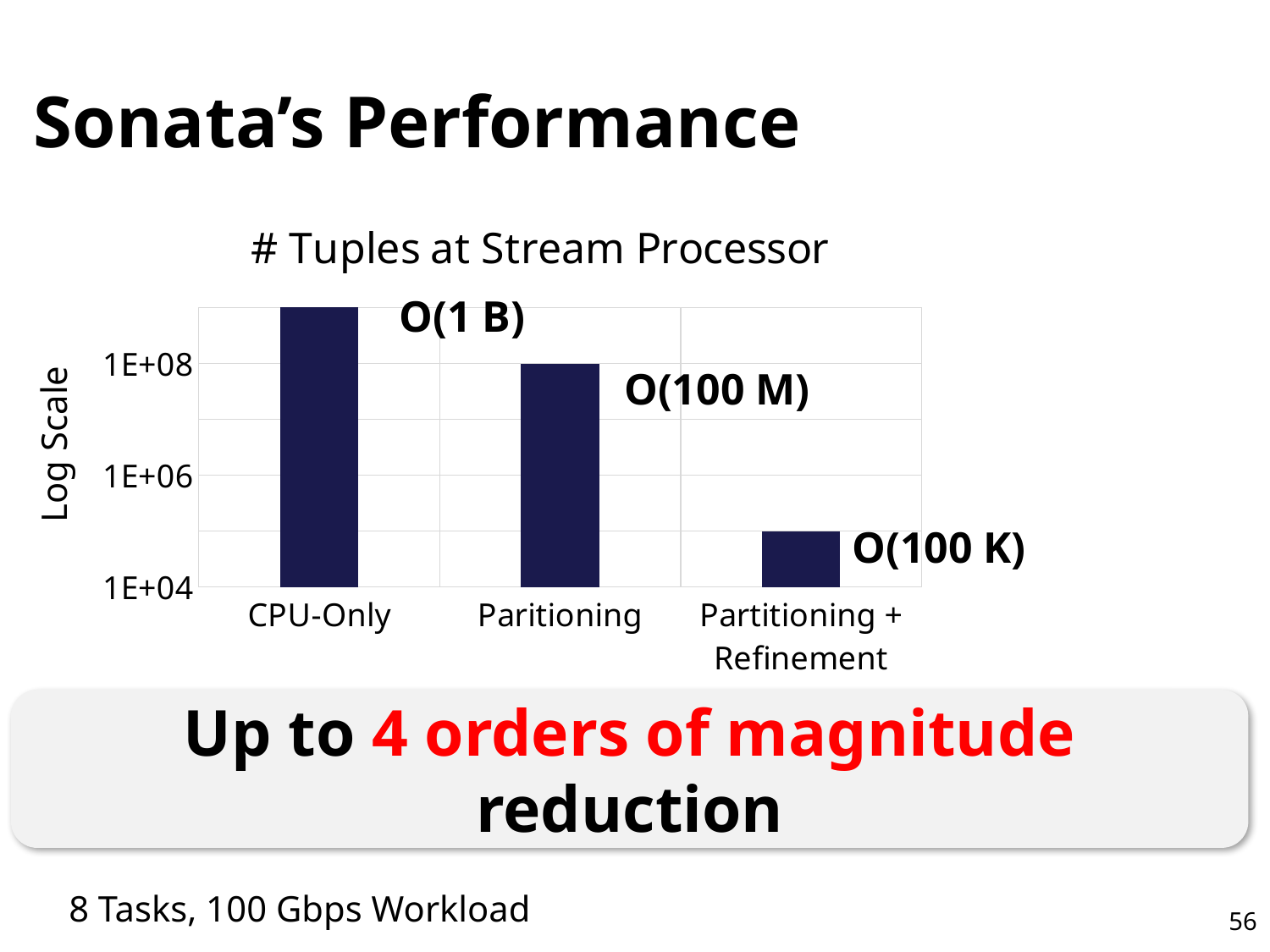
What kind of chart is shown on the slide? bar chart What is the label on the vertical axis of the chart? Log Scale How many categories are plotted in the chart? 3 What label is printed next to the CPU-Only bar? O(1 B) Is the value for CPU-Only greater or less than 1E+08? greater Do the bar values rise or fall from left to right across the categories? fall What is the title of the chart? # Tuples at Stream Processor Which category has the highest bar in the chart? CPU-Only Which category has the lowest bar in the chart? Partitioning + Refinement What label is printed next to the Paritioning bar? O(100 M) Is the value for Paritioning + Refinement greater or less than 1E+06? less What label is printed next to the Paritioning + Refinement bar? O(100 K)